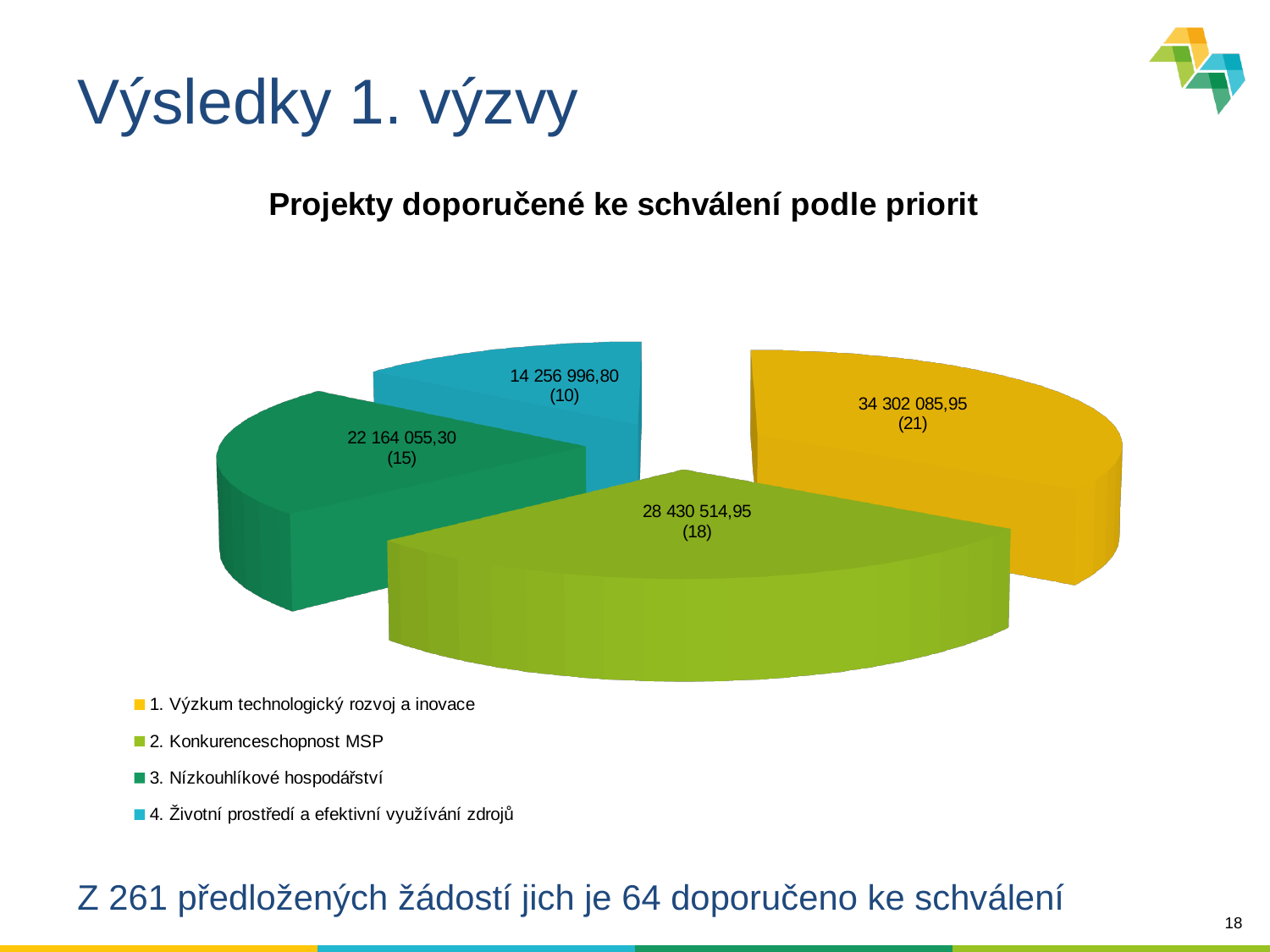
Which has a larger value: '3. Nízkouhlíkové hospodářství' or '4. Životní prostředí a efektivní využívání zdrojů'? 3. Nízkouhlíkové hospodářství What kind of chart is shown on the slide? Pie chart Which priority has the largest slice of the pie? 1. Výzkum technologický rozvoj a inovace What value is shown for the slice '4. Životní prostředí a efektivní využívání zdrojů'? 14 256 996,80 How many slices does the pie chart have? 4 What colour is the slice for '2. Konkurenceschopnost MSP'? Light green What is the title of the chart? Projekty doporučené ke schválení podle priorit What value is shown for the slice '1. Výzkum technologický rozvoj a inovace'? 34 302 085,95 Which priority has the smallest slice of the pie? 4. Životní prostředí a efektivní využívání zdrojů What is the difference between the values for '1. Výzkum technologický rozvoj a inovace' and '2. Konkurenceschopnost MSP'? 5 871 571,00 How many projects are shown in parentheses for '2. Konkurenceschopnost MSP'? 18 How many projects are shown in parentheses for '3. Nízkouhlíkové hospodářství'? 15